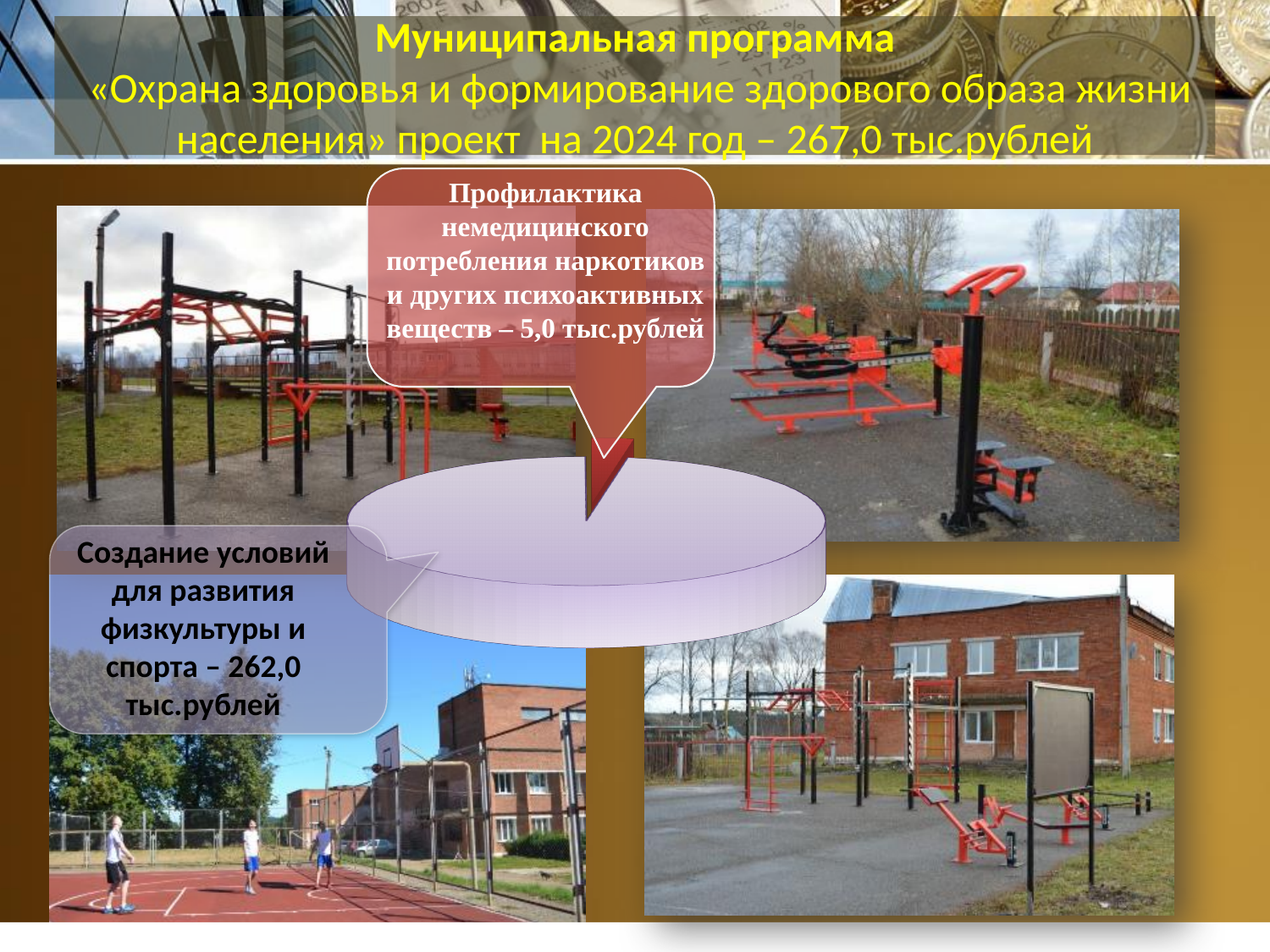
Which slice of the pie chart is the smallest? Профилактика немедицинского потребления наркотиков и других психоактивных веществ What amount is allocated to «Создание условий для развития физкультуры и спорта» in the pie chart? 262,0 тыс.рублей How many slices does the pie chart have? 2 What amount is allocated to «Профилактика немедицинского потребления наркотиков и других психоактивных веществ» in the pie chart? 5,0 тыс.рублей What is the difference between the amount for развитие физкультуры и спорта (262,0 тыс.рублей) and the amount for профилактика потребления наркотиков (5,0 тыс.рублей)? 257,0 тыс.рублей What is the total amount of the programme project shown in the pie chart for 2024? 267,0 тыс.рублей Which is larger: the amount for развитие физкультуры и спорта or the amount for профилактика потребления наркотиков? Развитие физкультуры и спорта For which year is the programme project in the pie chart planned? 2024 What kind of chart is shown on the slide? Pie chart What is the name of the municipal programme whose funding the pie chart shows? «Охрана здоровья и формирование здорового образа жизни населения» Which slice of the pie chart is the largest? Создание условий для развития физкультуры и спорта